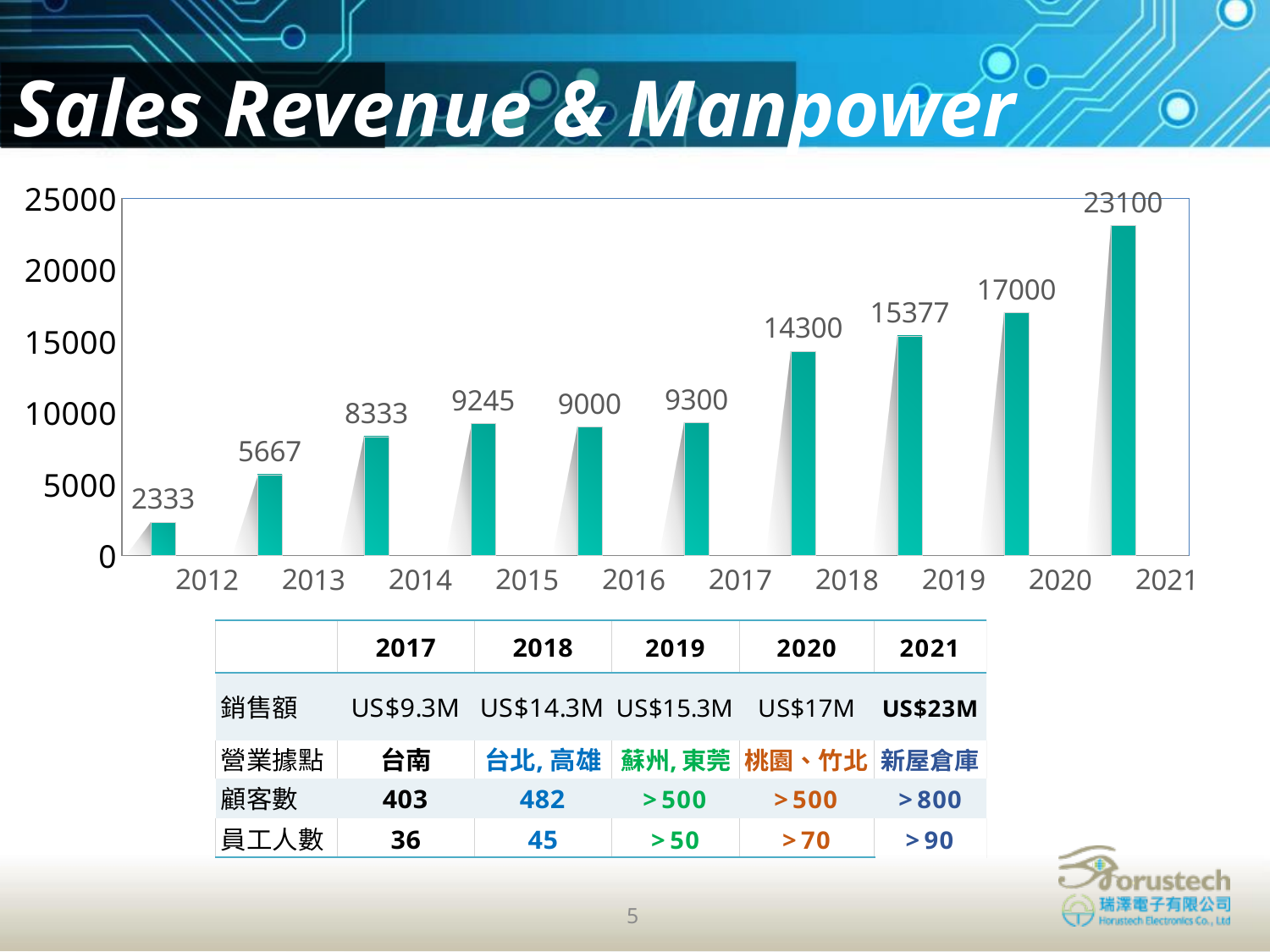
Which year has the highest value? 2021 What kind of chart is shown on the slide? bar chart What is the value for 2018? 14300 Which is larger, the value for 2015 or the value for 2016? 2015 Which year has the lowest value? 2012 Is the value for 2019 greater or less than 15000? greater What is the difference between the values for 2021 and 2020? 6100 What is the value for 2012? 2333 Do the values generally rise or fall from 2012 to 2021? rise What is the value for 2021? 23100 What is the difference between the values for 2013 and 2012? 3334 How many years are shown on the x axis of the chart? 10